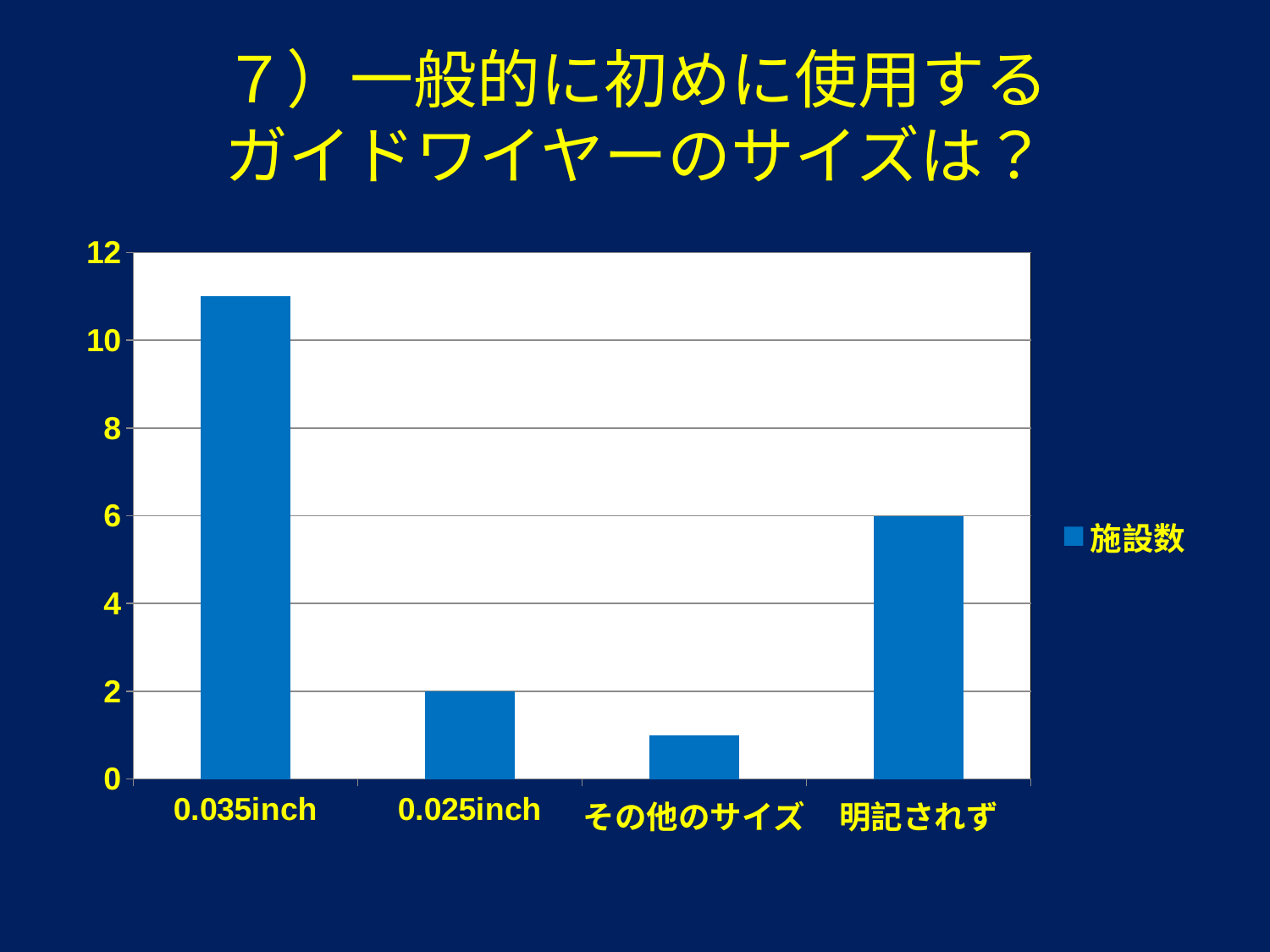
What is the value for 明記されず? 6 Which category has the highest value? 0.035inch What is the value for 0.025inch? 2 How many categories are shown on the x axis of the chart? 4 Is the value for 0.035inch greater or less than 10? greater How many series does the legend list? 1 What is the name of the series shown in the legend? 施設数 Which is larger, the value for 明記されず or the value for 0.025inch? 明記されず Is the value for その他のサイズ greater or less than 2? less What is the difference between the value for 明記されず and the value for 0.025inch? 4 What kind of chart is shown on the slide? bar chart Which category has the lowest value? その他のサイズ